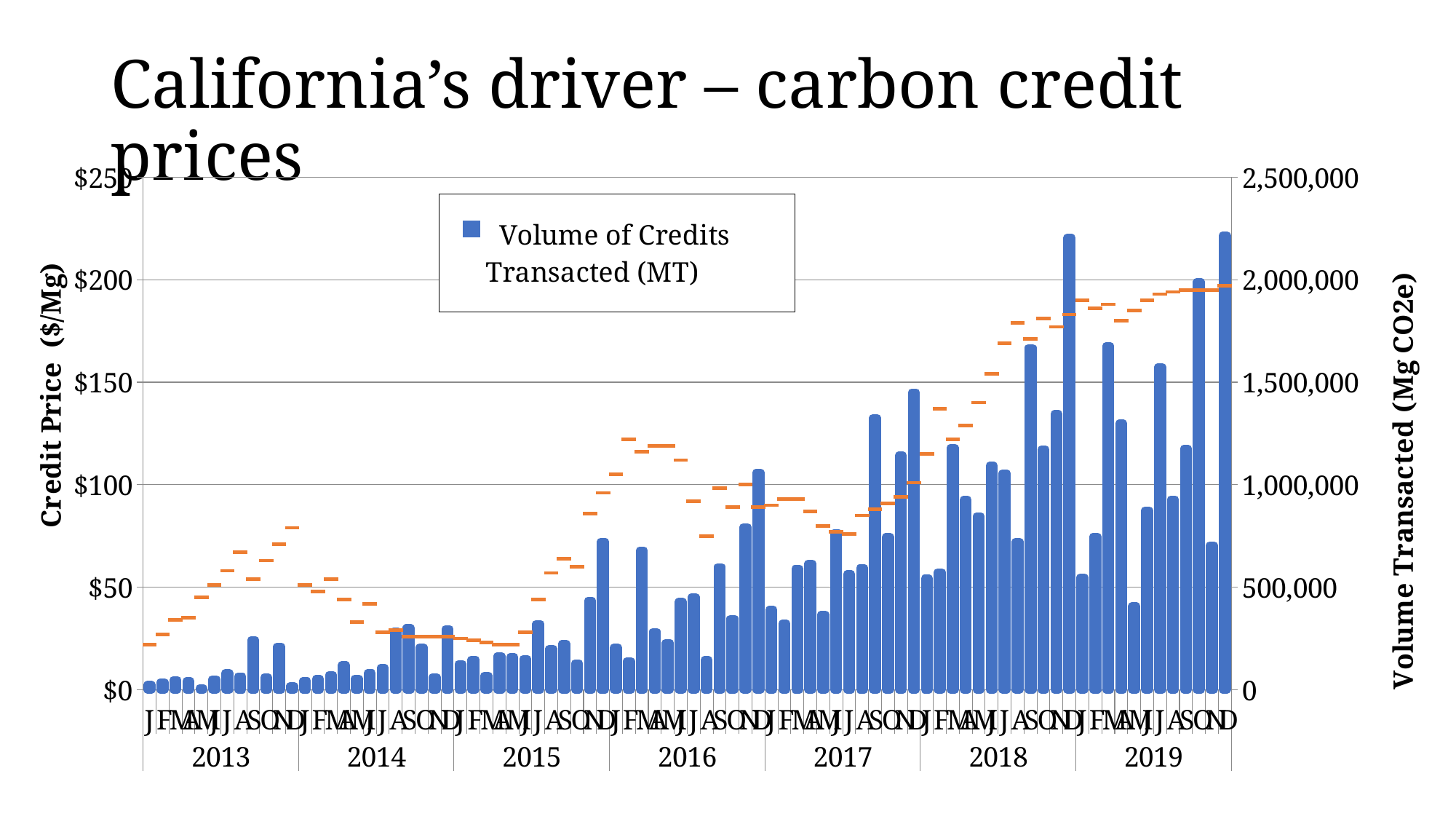
Does the credit price generally rise or fall from 2013 to 2019? rise What is the title of the slide? California's driver – carbon credit prices How many years are labelled along the x axis? 7 Is the volume of credits transacted in January 2013 greater or less than 500,000? less How many series does the legend list? 1 In which year does the credit price reach its highest level? 2019 What entry does the chart legend list? Volume of Credits Transacted (MT) Is the credit price in January 2013 greater or less than $50? less Is the credit price in December 2019 greater or less than $150? greater What kind of chart is shown on the slide? combination bar and line chart